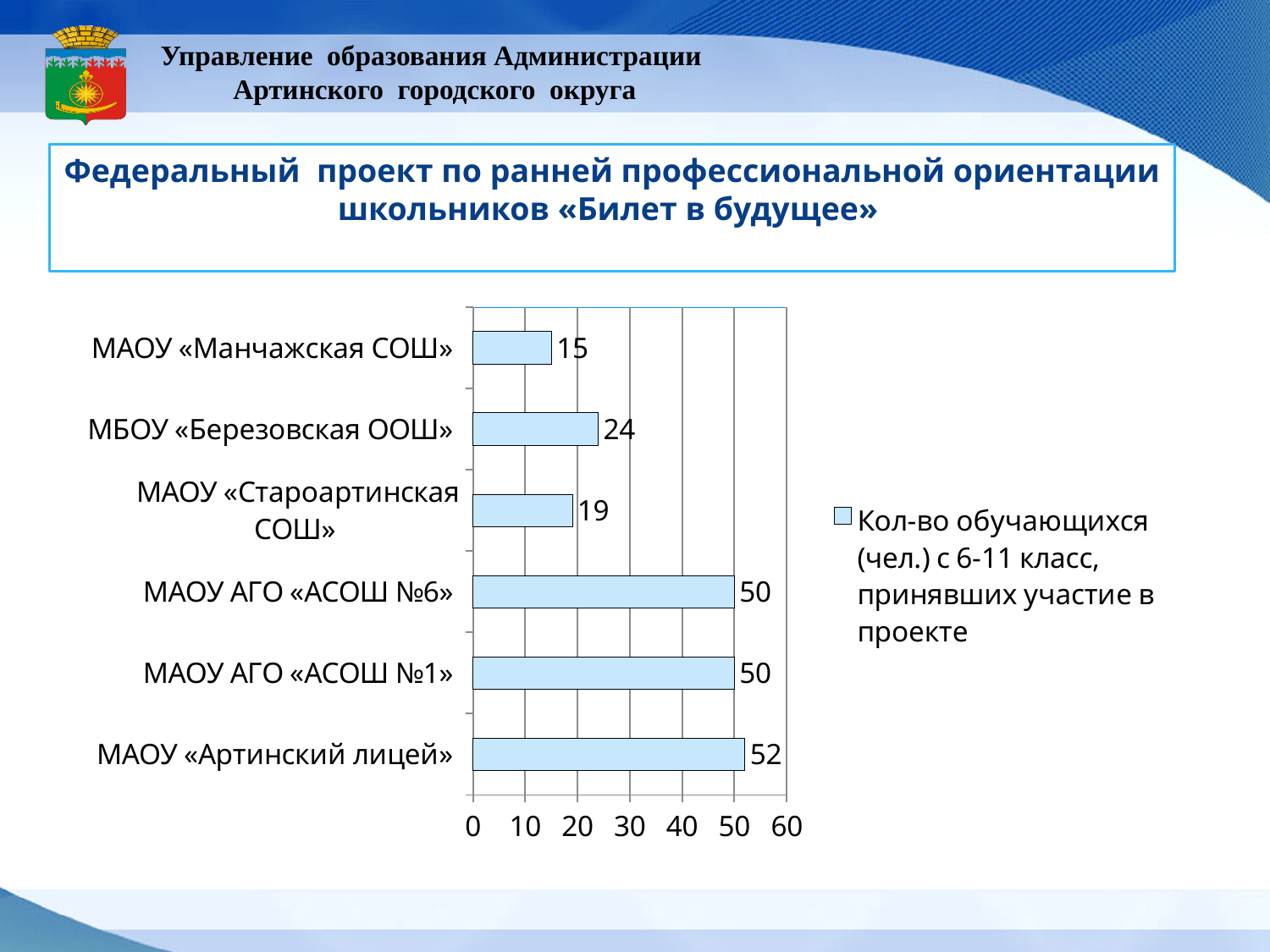
What is the legend entry of the chart? Кол-во обучающихся (чел.) с 6-11 класс, принявших участие в проекте Which school has the highest value? МАОУ «Артинский лицей» What is the difference between the values for МБОУ «Березовская ООШ» and МАОУ «Староартинская СОШ»? 5 Which school has the lowest value? МАОУ «Манчажская СОШ» Which is larger, the value for МБОУ «Березовская ООШ» or the value for МАОУ «Манчажская СОШ»? МБОУ «Березовская ООШ» What is the value for МАОУ «Артинский лицей»? 52 What is the difference between the values for МАОУ «Артинский лицей» and МАОУ «Манчажская СОШ»? 37 How many series does the legend list? 1 What is the value for МАОУ «Староартинская СОШ»? 19 What kind of chart is shown on the slide? bar chart What is the value for МБОУ «Березовская ООШ»? 24 How many schools are shown in the chart? 6